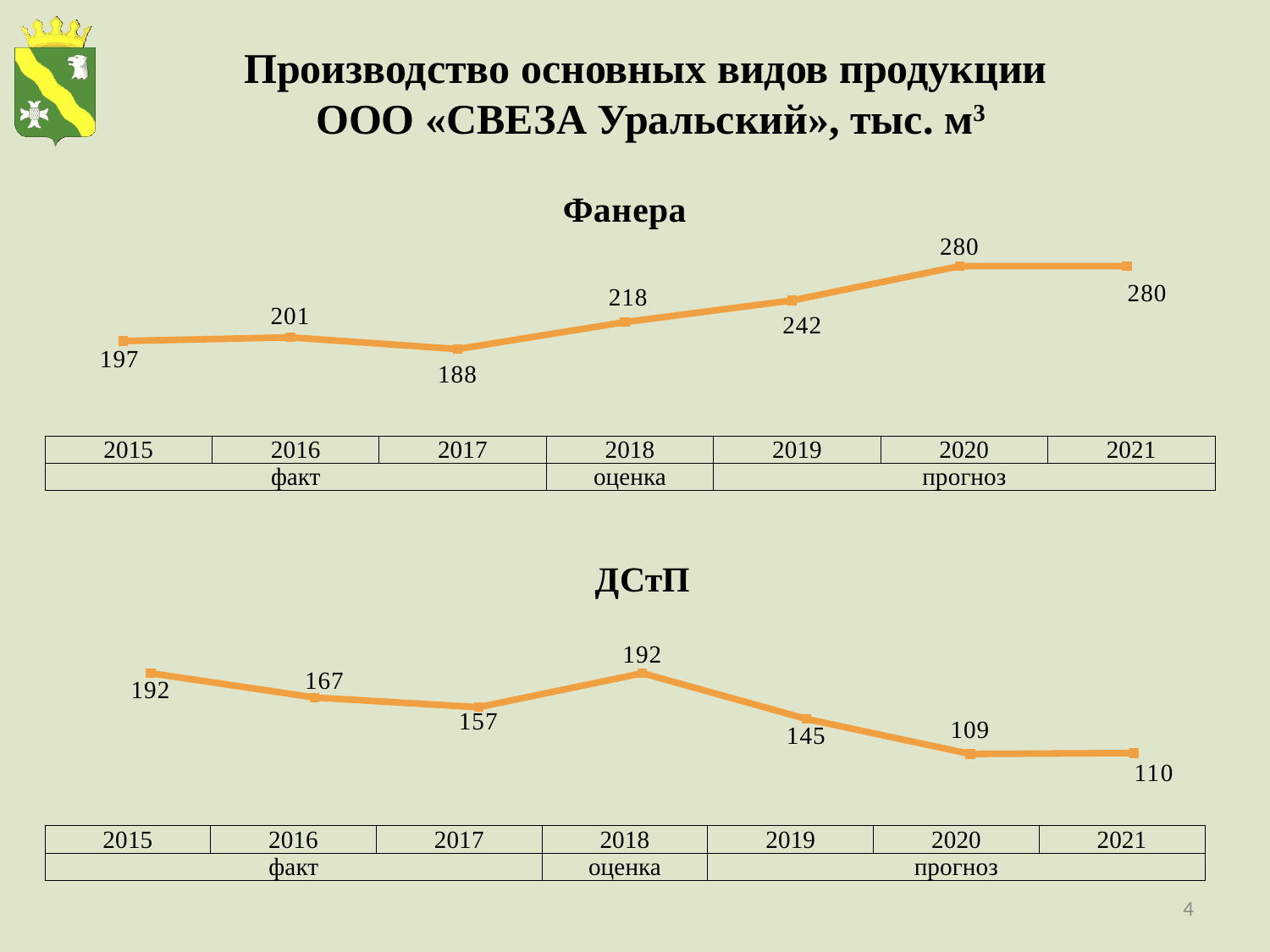
In the "Фанера" chart, which year has the lowest value? 2017 In the "ДСтП" chart, which is larger, the value for 2016 or the value for 2019? 2016 In the "ДСтП" chart, what is the value for 2018? 192 In the "Фанера" chart, what is the difference between the values for 2020 and 2015? 83 In the "ДСтП" chart, what is the difference between the values for 2018 and 2017? 35 What type of chart is the "ДСтП" chart? line chart In the "ДСтП" chart, do the values rise or fall from 2018 to 2020? fall In the "ДСтП" chart, which year has the lowest value? 2020 In the "Фанера" chart, what is the value for 2019? 242 In the "Фанера" chart, what is the value for 2017? 188 In the "ДСтП" chart, what is the value for 2020? 109 In the "Фанера" chart, how many years are plotted? 7